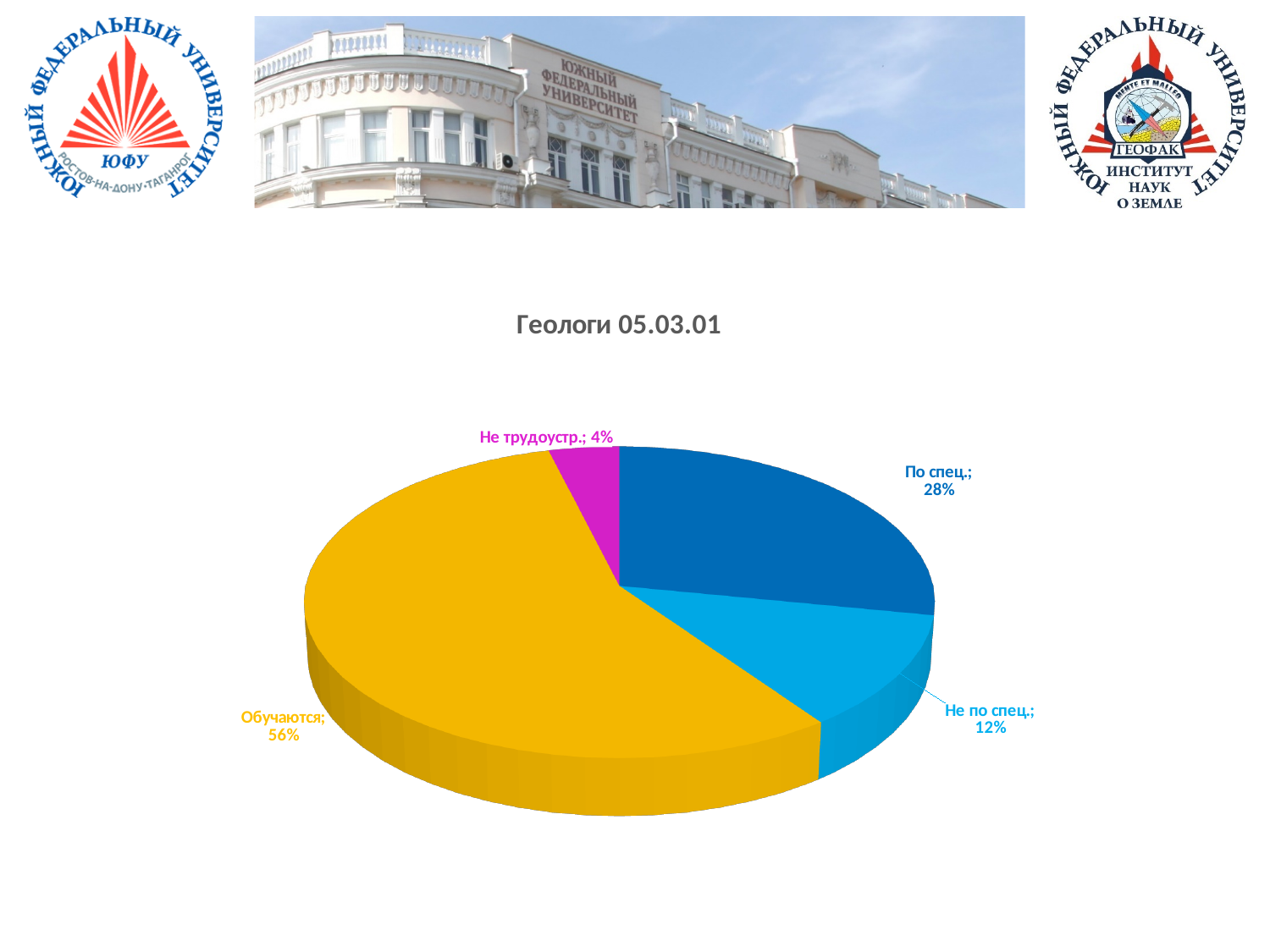
What is the title of the chart? Геологи 05.03.01 What share of the pie is labelled "Не по спец."? 12% Which category has the smallest slice of the pie? Не трудоустр. What share of the pie is labelled "Не трудоустр."? 4% What kind of chart is shown on the slide? pie chart Which is larger, the share for "По спец." or the share for "Не по спец."? По спец. What colour is the "Обучаются" slice? yellow What share of the pie is labelled "По спец."? 28% Which category has the largest slice of the pie? Обучаются How many slices does the pie chart have? 4 What is the difference in percentage points between "Обучаются" and "По спец."? 28